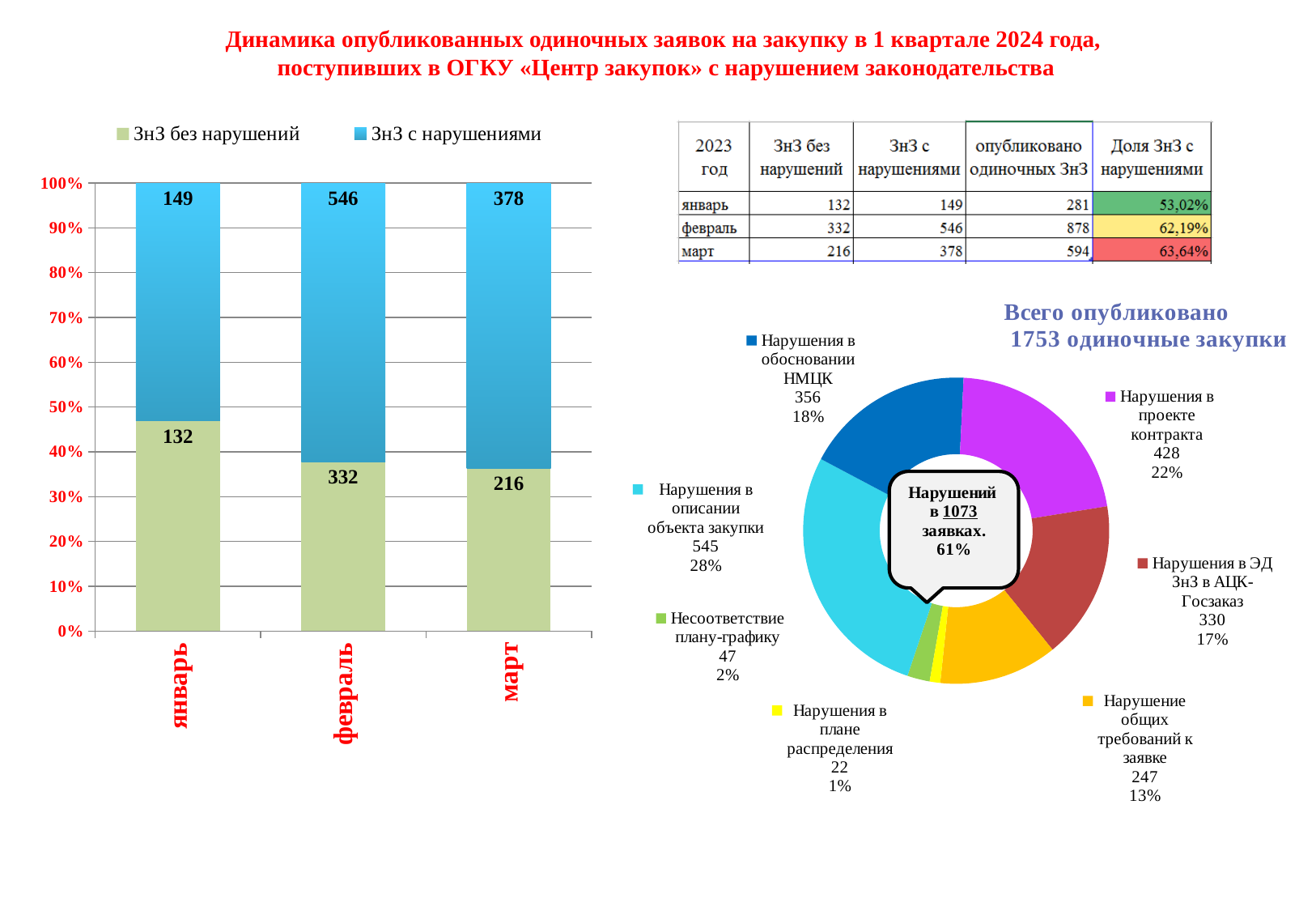
In the doughnut chart on the right, what share does 'Нарушения в проекте контракта' have? 22% In the stacked bar chart on the left, what is the total of the two series for январь? 281 In the doughnut chart on the right, what is the value for 'Нарушения в описании объекта закупки'? 545 In the stacked bar chart on the left, which month has the highest value for 'ЗнЗ с нарушениями'? февраль In the stacked bar chart on the left, what is the difference between 'ЗнЗ с нарушениями' and 'ЗнЗ без нарушений' for март? 162 In the doughnut chart on the right, which is larger: 'Нарушения в обосновании НМЦК' or 'Нарушения в ЭД ЗнЗ в АЦК-Госзаказ'? Нарушения в обосновании НМЦК In the stacked bar chart on the left, what is the value of 'ЗнЗ без нарушений' for март? 216 In the stacked bar chart on the left, which month has the lowest value for 'ЗнЗ без нарушений'? январь How many series does the legend of the stacked bar chart on the left list? 2 How many months are shown on the x axis of the bar chart on the left? 3 In the doughnut chart on the right, which category has the smallest value? Нарушения в плане распределения In the stacked bar chart on the left, what is the value of 'ЗнЗ с нарушениями' for февраль? 546